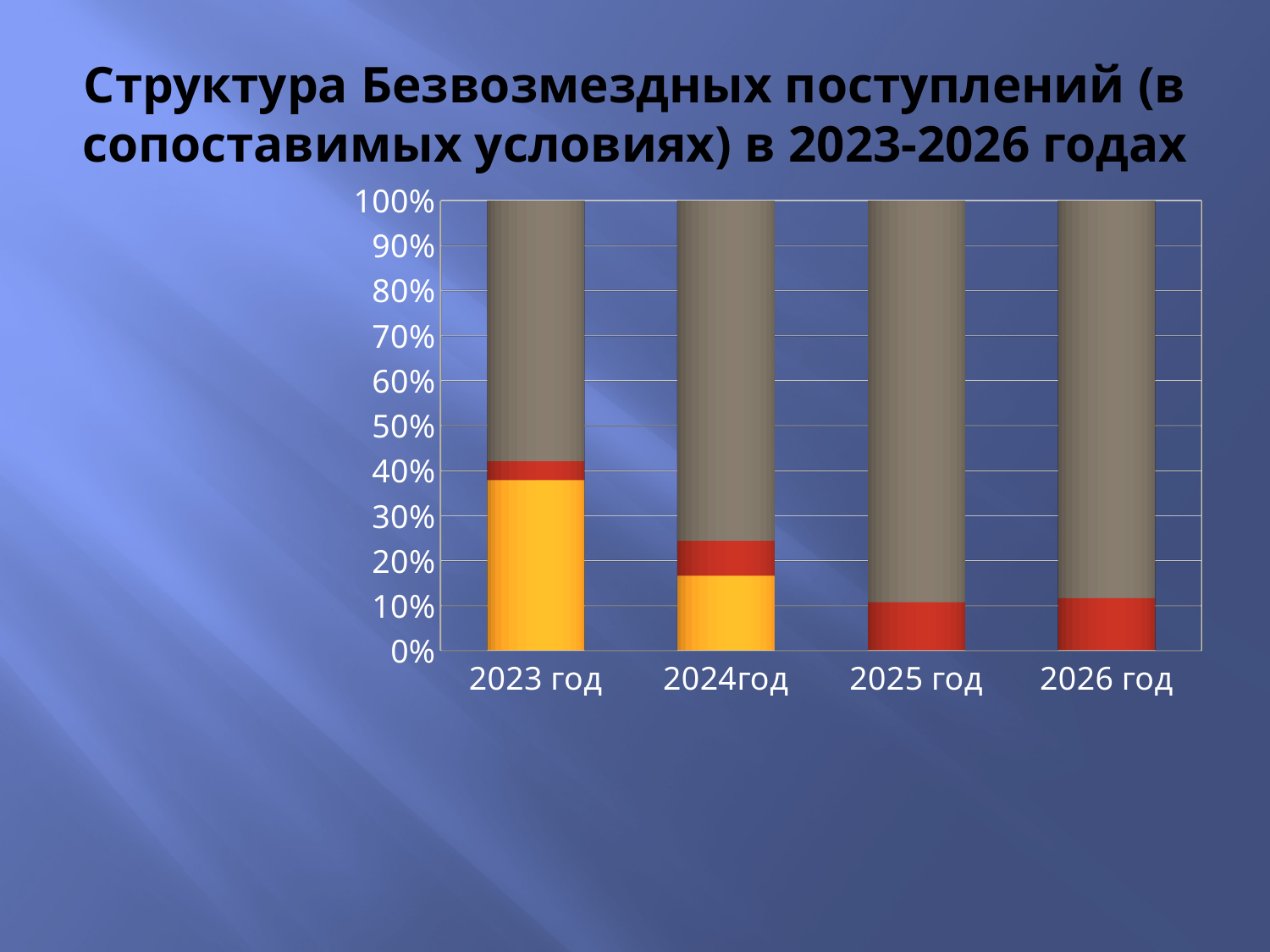
What is the highest value shown on the vertical axis? 100% Is the yellow segment for 2023 год greater or less than 30%? greater Which year has the smallest grey segment? 2023 год What is the title of the chart? Структура Безвозмездных поступлений (в сопоставимых условиях) в 2023-2026 годах Is the red segment for 2025 год greater or less than 20%? less Which year has the largest yellow segment? 2023 год Which year has the larger yellow segment, 2023 год or 2024год? 2023 год Does the yellow segment rise or fall from 2023 год to 2024год? fall What kind of chart is shown on the slide? bar chart Is the yellow segment for 2024год greater or less than 20%? less How many year categories are shown on the x axis? 4